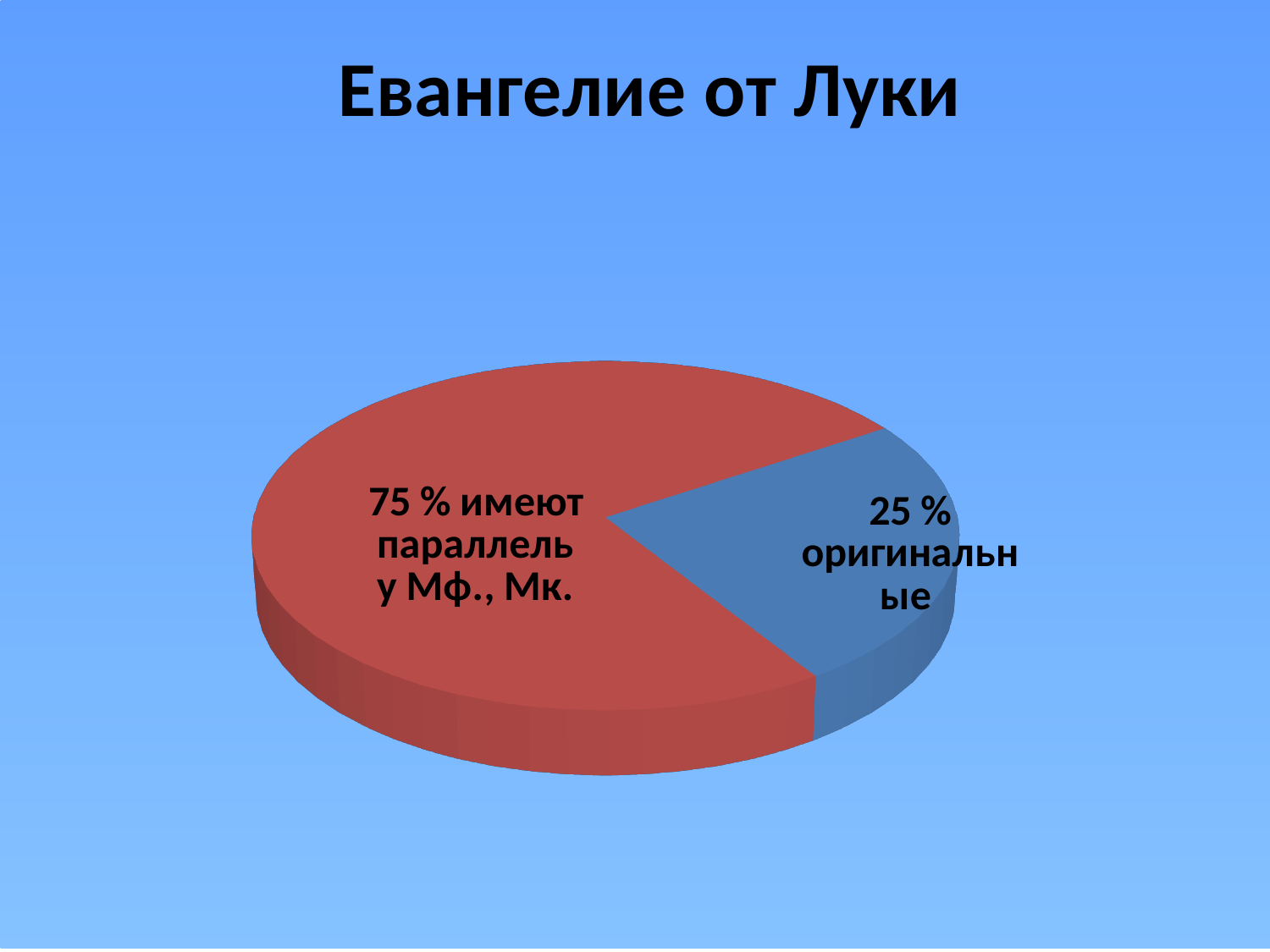
What kind of chart is shown on the slide? pie chart Which slice is the smallest? 25 % оригинальные What share of the pie is labelled as original (оригинальные)? 25 % What colour is the slice labelled 25 % оригинальные? blue What share of the pie is labelled as having parallels in Matthew and Mark (параллель у Мф., Мк.)? 75 % How many slices does the pie chart have? 2 Which slice is the largest? 75 % имеют параллель у Мф., Мк. What is the difference in percentage points between the slice with parallels and the original slice? 50 % What is the title of the slide? Евангелие от Луки Which is larger: the slice with parallels in Matthew and Mark or the original slice? the slice with parallels in Matthew and Mark